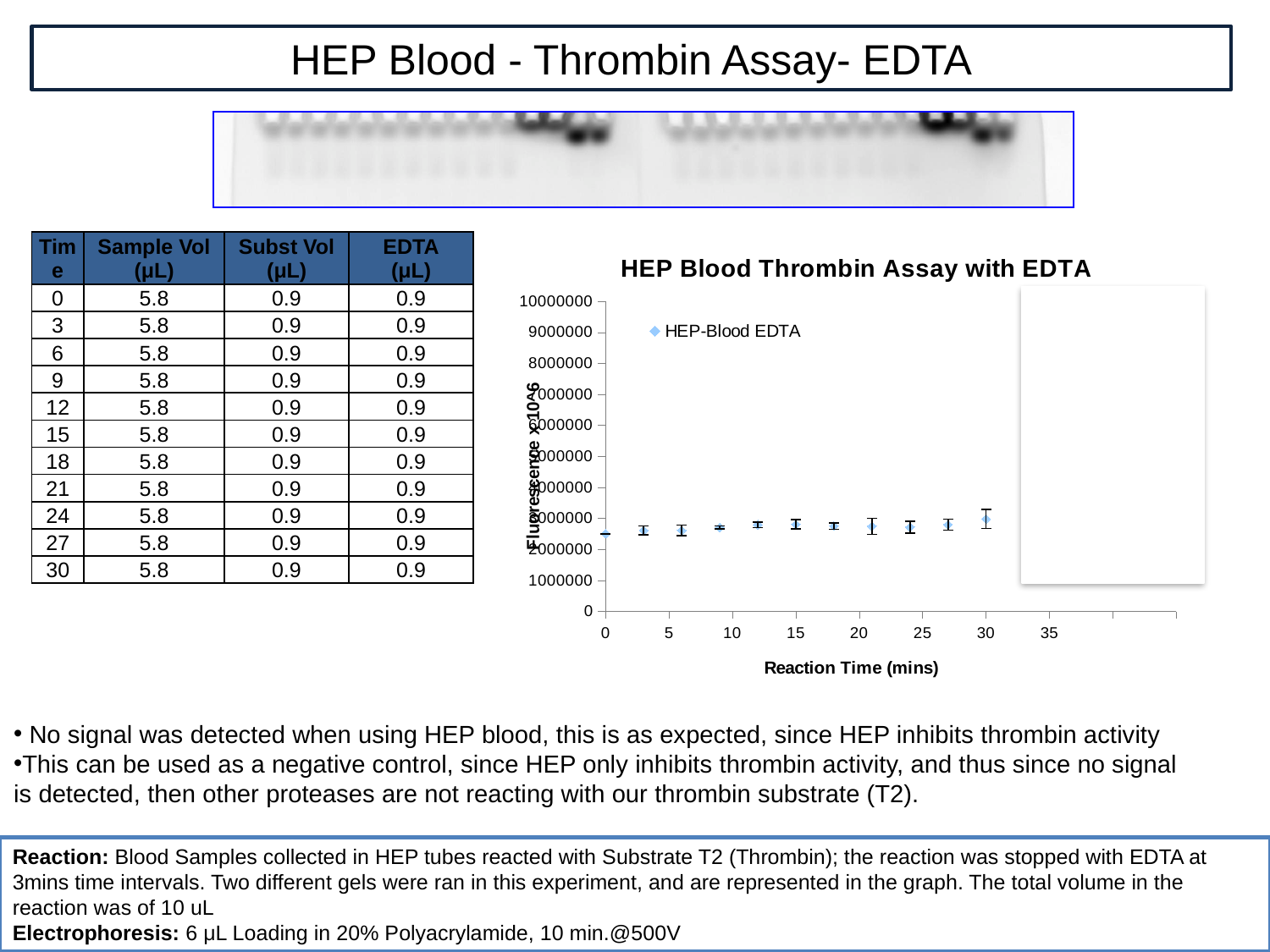
What kind of chart is shown on the slide? scatter chart Is the value for HEP-Blood EDTA at 30 minutes greater or less than 1000000? greater Which is larger, the value for HEP-Blood EDTA at 0 minutes or at 30 minutes? 30 minutes What is the title of the chart? HEP Blood Thrombin Assay with EDTA Is the value for HEP-Blood EDTA at 0 minutes greater or less than 4000000? less Do the HEP-Blood EDTA values generally rise or fall as reaction time increases from 0 to 30 minutes? rise What is the name of the series shown in the chart legend? HEP-Blood EDTA How many data points are plotted in the chart? 11 How many series does the chart legend list? 1 Is the value for HEP-Blood EDTA at 30 minutes greater or less than 5000000? less What is the maximum value shown on the y axis of the chart? 10000000